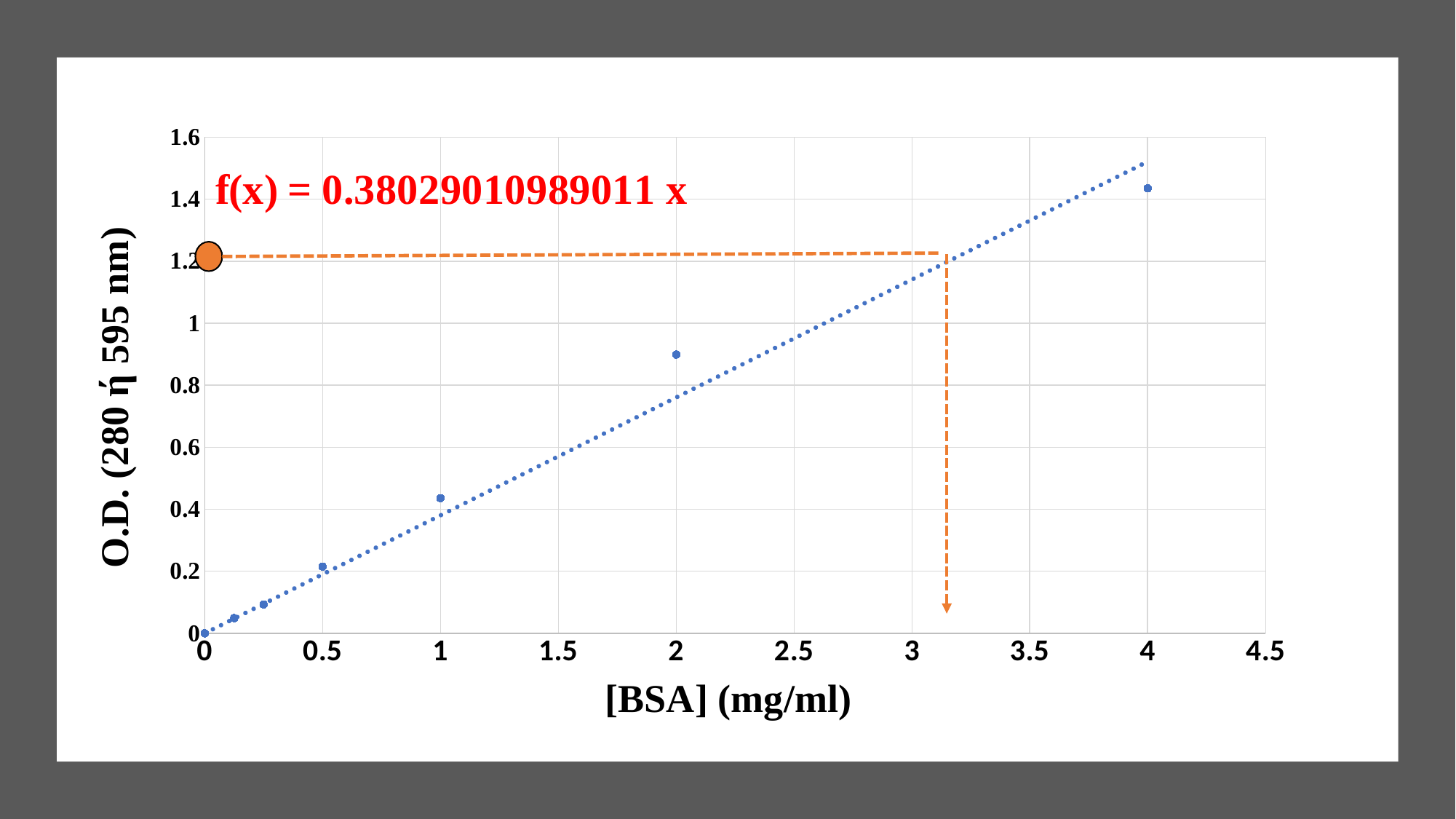
At which [BSA] concentration is the plotted O.D. value lowest? 0 Is the O.D. value at [BSA] = 4 mg/ml greater or less than 1.6? less Which has the larger O.D. value: [BSA] = 1 mg/ml or [BSA] = 2 mg/ml? 2 mg/ml Do the O.D. values rise or fall as [BSA] increases along the x axis? rise What is the title of the x axis? [BSA] (mg/ml) What is the trendline equation shown on the chart? f(x) = 0.38029010989011 x Is the O.D. value at [BSA] = 1 mg/ml greater or less than 0.6? less What kind of chart is shown on the slide? scatter chart At which [BSA] concentration is the plotted O.D. value highest? 4 Is the O.D. value at [BSA] = 0.5 mg/ml greater or less than 0.4? less